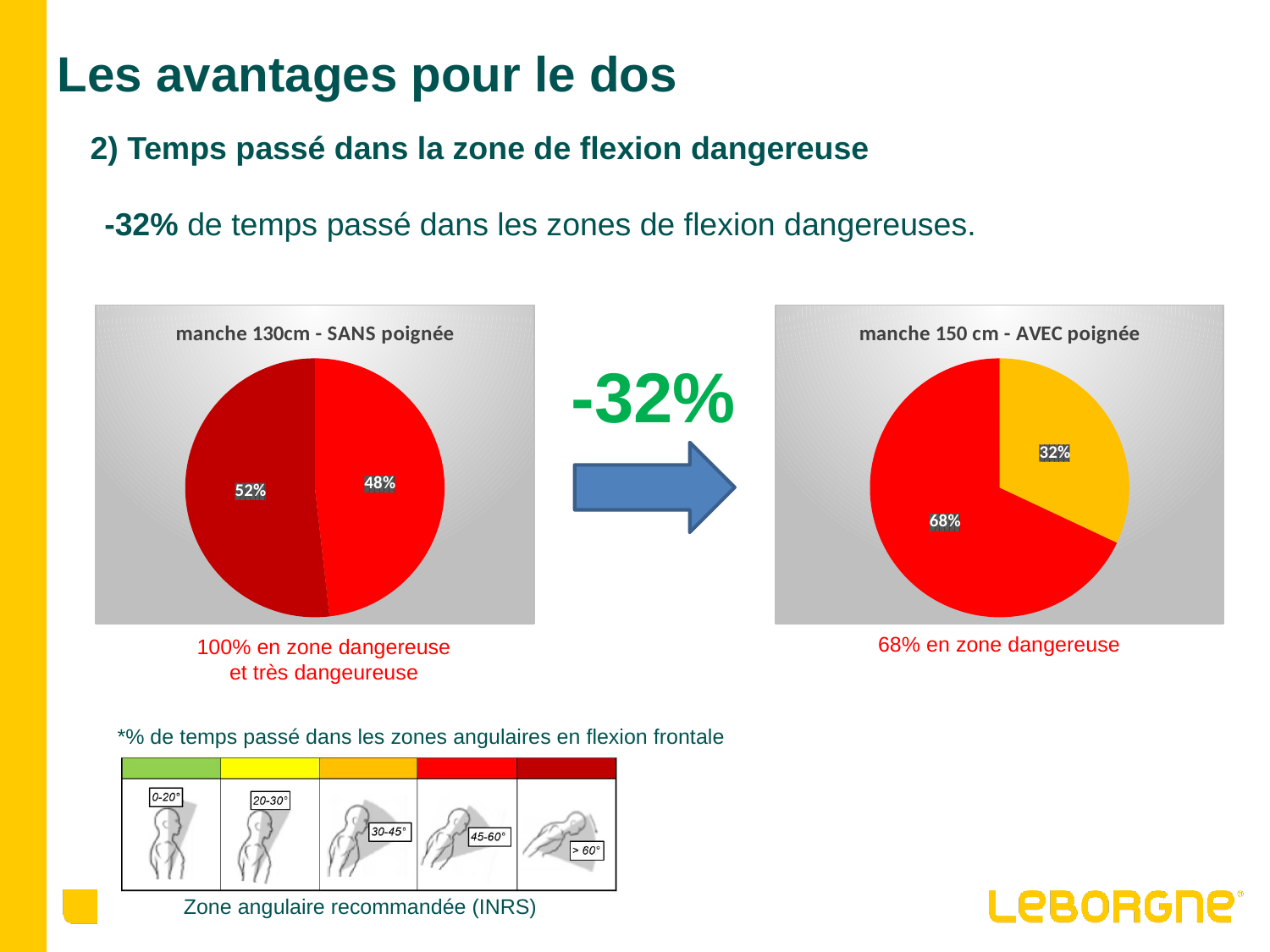
In the "manche 150 cm - AVEC poignée" pie chart, what percentage is shown on the yellow slice? 32% In the "manche 130cm - SANS poignée" pie chart, what percentage is shown on the dark red slice? 52% What kind of chart is shown under the title "manche 130cm - SANS poignée"? Pie chart In the "manche 150 cm - AVEC poignée" pie chart, which slice is larger, the red one or the yellow one? The red one (68%) In the "manche 150 cm - AVEC poignée" pie chart, what is the difference between the red slice and the yellow slice? 36 percentage points What is the title of the pie chart on the right side of the slide? manche 150 cm - AVEC poignée How many slices does the "manche 150 cm - AVEC poignée" pie chart have? 2 In the "manche 130cm - SANS poignée" pie chart, what is the value of the largest slice? 52% In the "manche 150 cm - AVEC poignée" pie chart, what percentage is shown on the red slice? 68% Which pie chart has the larger bright red slice, "manche 130cm - SANS poignée" or "manche 150 cm - AVEC poignée"? manche 150 cm - AVEC poignée In the "manche 130cm - SANS poignée" pie chart, what percentage is shown on the bright red slice? 48% In the "manche 130cm - SANS poignée" pie chart, what is the difference between the two slices? 4 percentage points